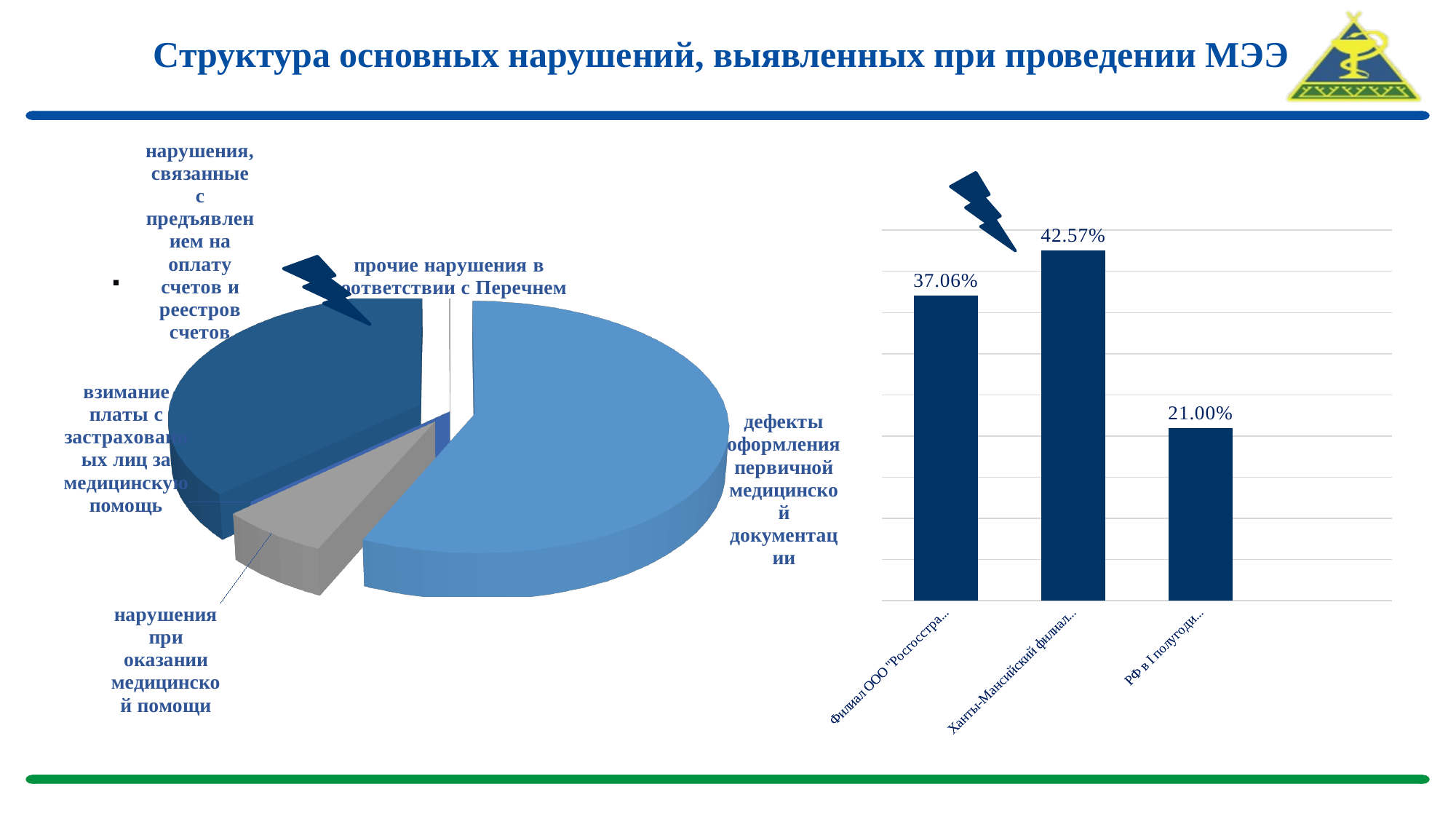
In the bar chart on the right, what is the value for the bar labelled "Ханты-Мансийский филиал..."? 42.57% In the bar chart on the right, what is the value for the bar labelled "РФ в I полугоди..."? 21.00% In the bar chart on the right, which bar has the lowest value? РФ в I полугоди... How many categories are labelled in the pie chart on the left? 5 In the bar chart on the right, which is larger: the value for "Филиал ООО "Росгосстра..." or the value for "РФ в I полугоди..."? Филиал ООО "Росгосстра... What type of chart is on the right side of the slide? bar chart In the pie chart on the left, which category has the largest slice? дефекты оформления первичной медицинской документации What type of chart is on the left side of the slide? pie chart In the bar chart on the right, what is the value for the bar labelled "Филиал ООО "Росгосстра..."? 37.06% In the bar chart on the right, which bar has the highest value? Ханты-Мансийский филиал... In the bar chart on the right, what is the difference between the values for "Ханты-Мансийский филиал..." and "РФ в I полугоди..."? 21.57% How many bars are in the bar chart on the right? 3